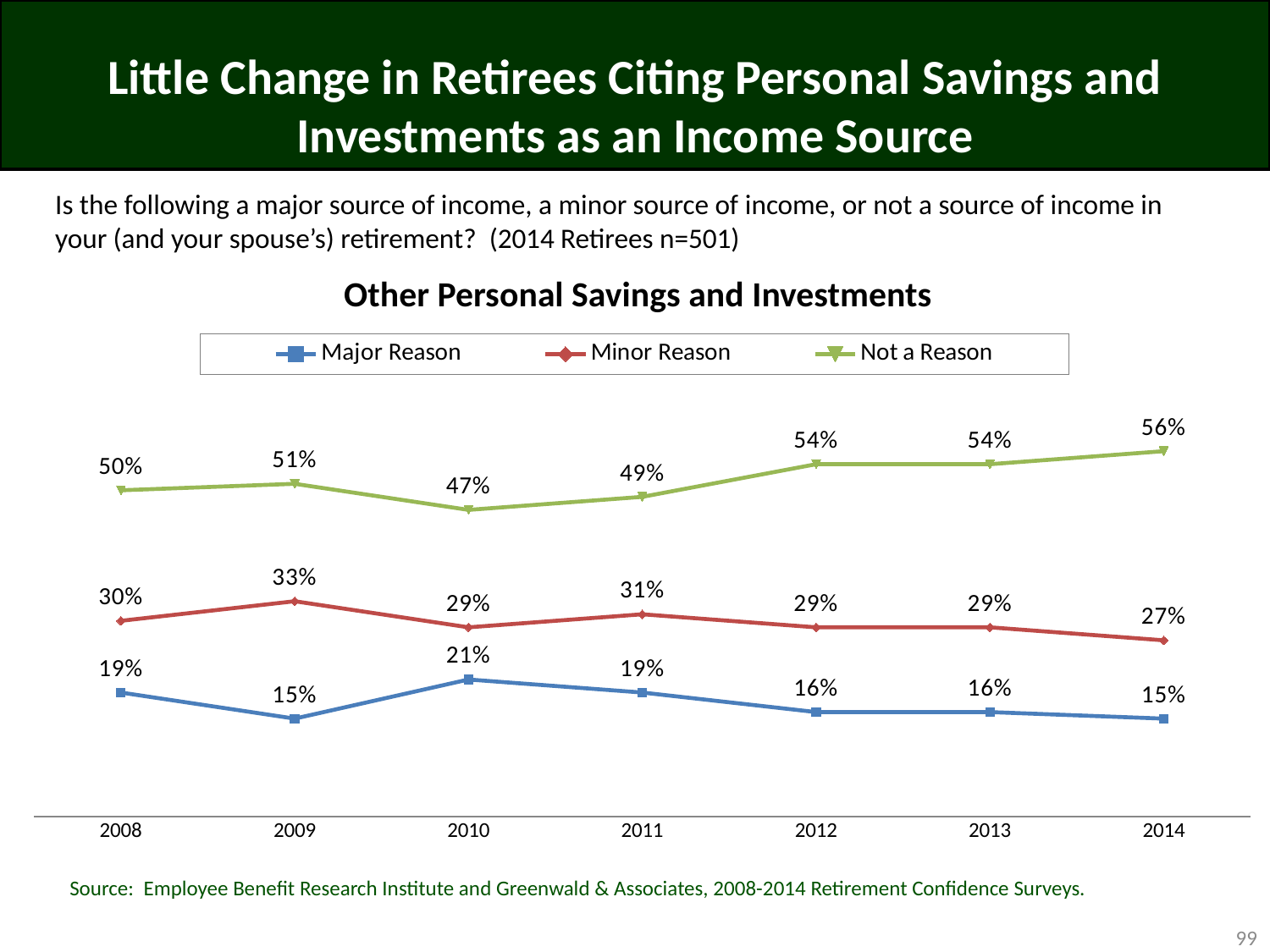
What kind of chart is shown on the slide? Line chart What is the difference between the Not a Reason and Major Reason values in 2014? 41 percentage points In which year was the Major Reason value highest? 2010 Did the Not a Reason value rise or fall from 2011 to 2014? Rise What is the title of the chart? Other Personal Savings and Investments What is the value for Minor Reason in 2009? 33% How many years are shown on the x axis? 7 In which year was the Not a Reason value lowest? 2010 How many series does the legend list? 3 Which is larger in 2011: the Minor Reason value or the Major Reason value? Minor Reason What is the value for Not a Reason in 2014? 56% What percentage of retirees cited other personal savings and investments as a Major Reason in 2010? 21%